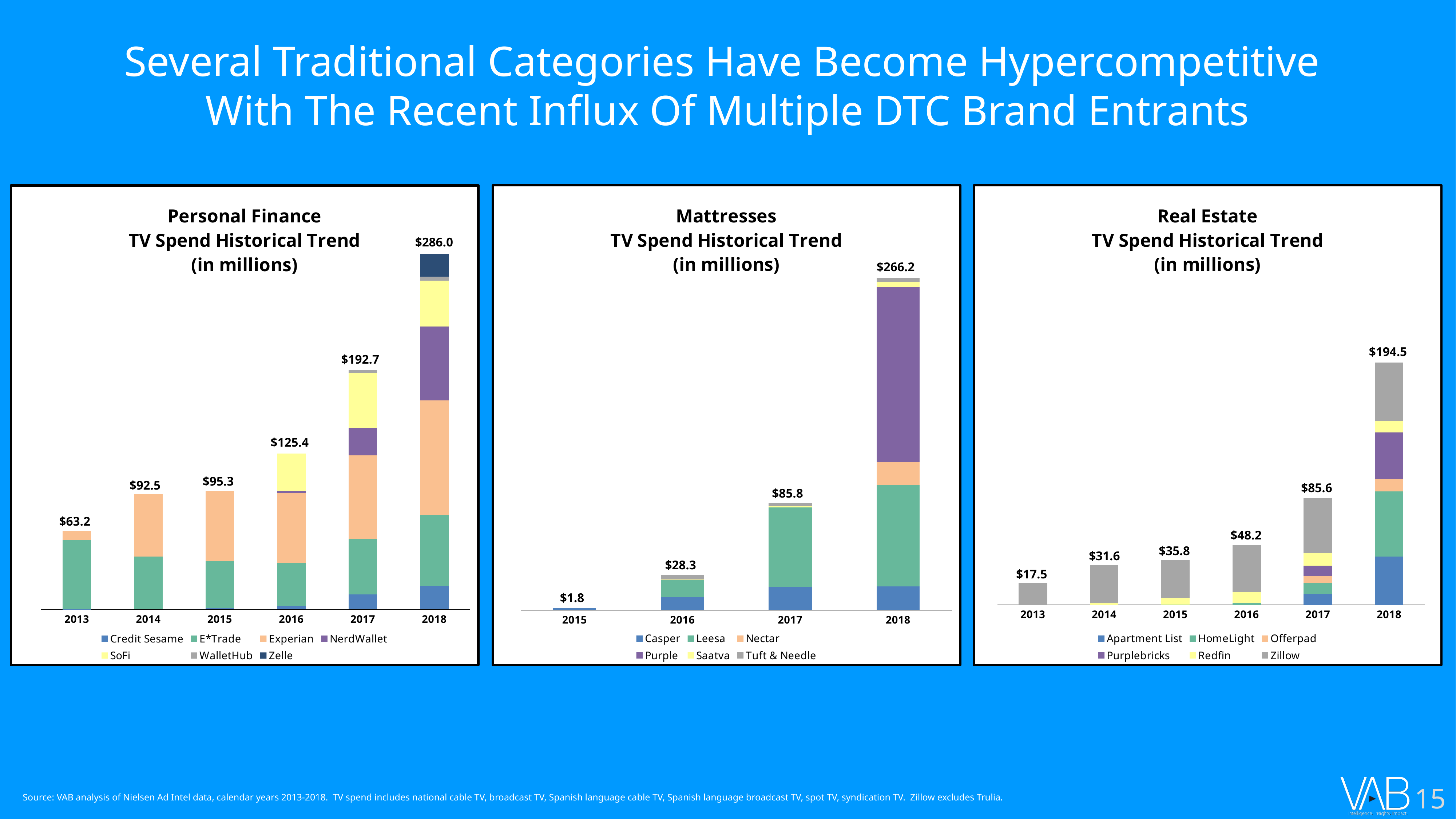
Which is larger: the 2018 total in the Personal Finance chart or the 2018 total in the Mattresses chart? Personal Finance ($286.0) In the Real Estate chart, which year has the lowest total TV spend? 2013 In the Mattresses chart, how much larger is the 2018 total than the 2017 total? $180.4 How many brands does the legend of the Personal Finance chart list? 7 How many years are shown in the Mattresses chart? 4 In the Real Estate chart, do the total values rise or fall from 2013 to 2018? Rise In the Personal Finance chart, what is the total TV spend for 2018? $286.0 In the Personal Finance chart, what is the difference between the 2018 and 2017 totals? $93.3 In the Real Estate chart, what is the total TV spend for 2016? $48.2 In the Mattresses chart, which year has the highest total TV spend? 2018 What type of chart is the Real Estate TV Spend Historical Trend chart? Stacked bar chart In the Mattresses chart, what is the total TV spend for 2015? $1.8